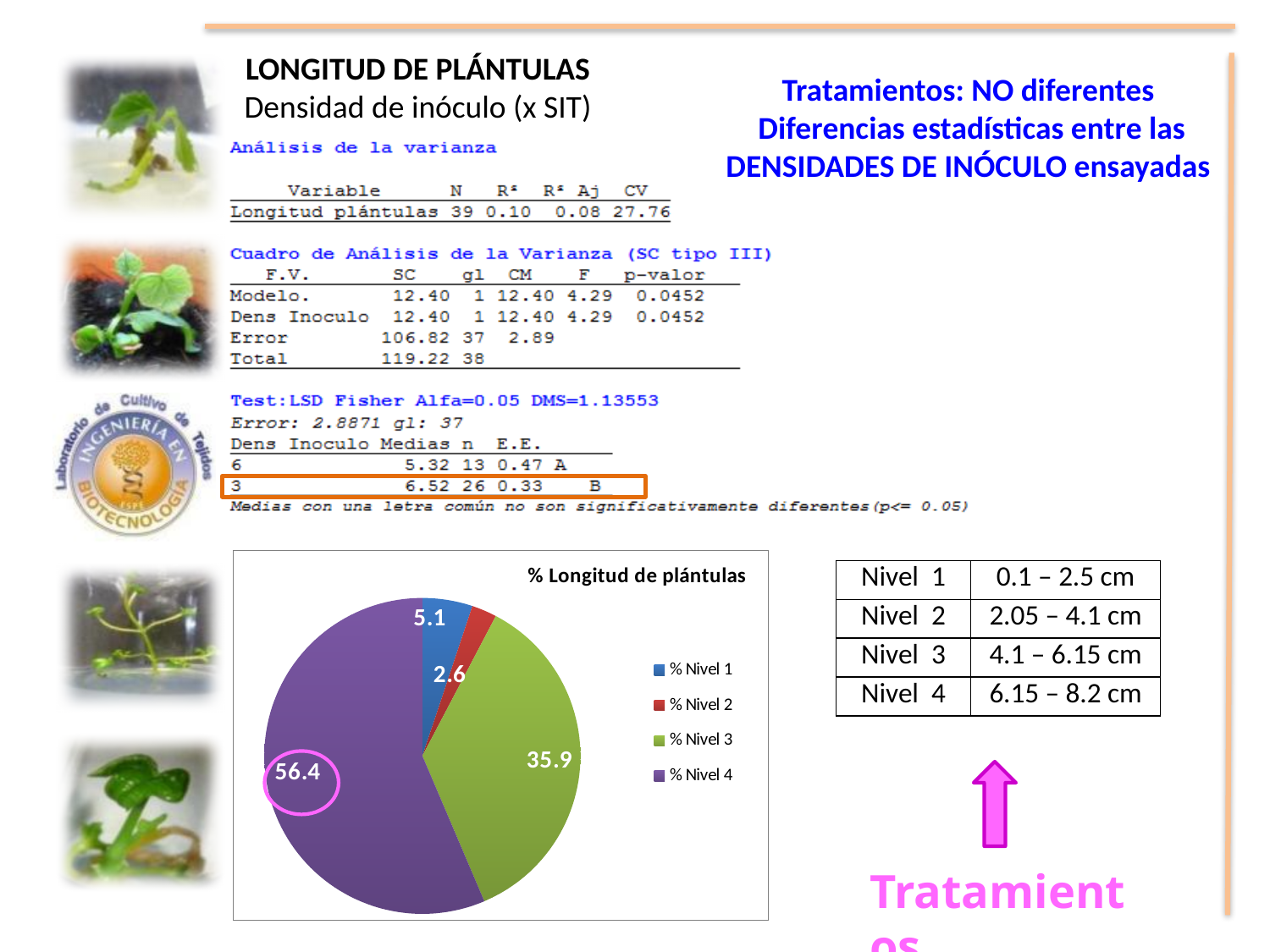
What is the value shown for % Nivel 3 in the pie chart? 35.9 Which slice of the pie chart is the largest? % Nivel 4 What is the value shown for % Nivel 1 in the pie chart? 5.1 How many slices does the pie chart have? 4 Which slice of the pie chart is the smallest? % Nivel 2 Which is larger in the pie chart, % Nivel 1 or % Nivel 2? % Nivel 1 What is the title of the pie chart? % Longitud de plántulas How many entries does the legend of the pie chart list? 4 What kind of chart is shown on the slide? pie chart What is the difference between the values for % Nivel 4 and % Nivel 3 in the pie chart? 20.5 What is the value shown for % Nivel 2 in the pie chart? 2.6 What is the value shown for % Nivel 4 in the pie chart? 56.4